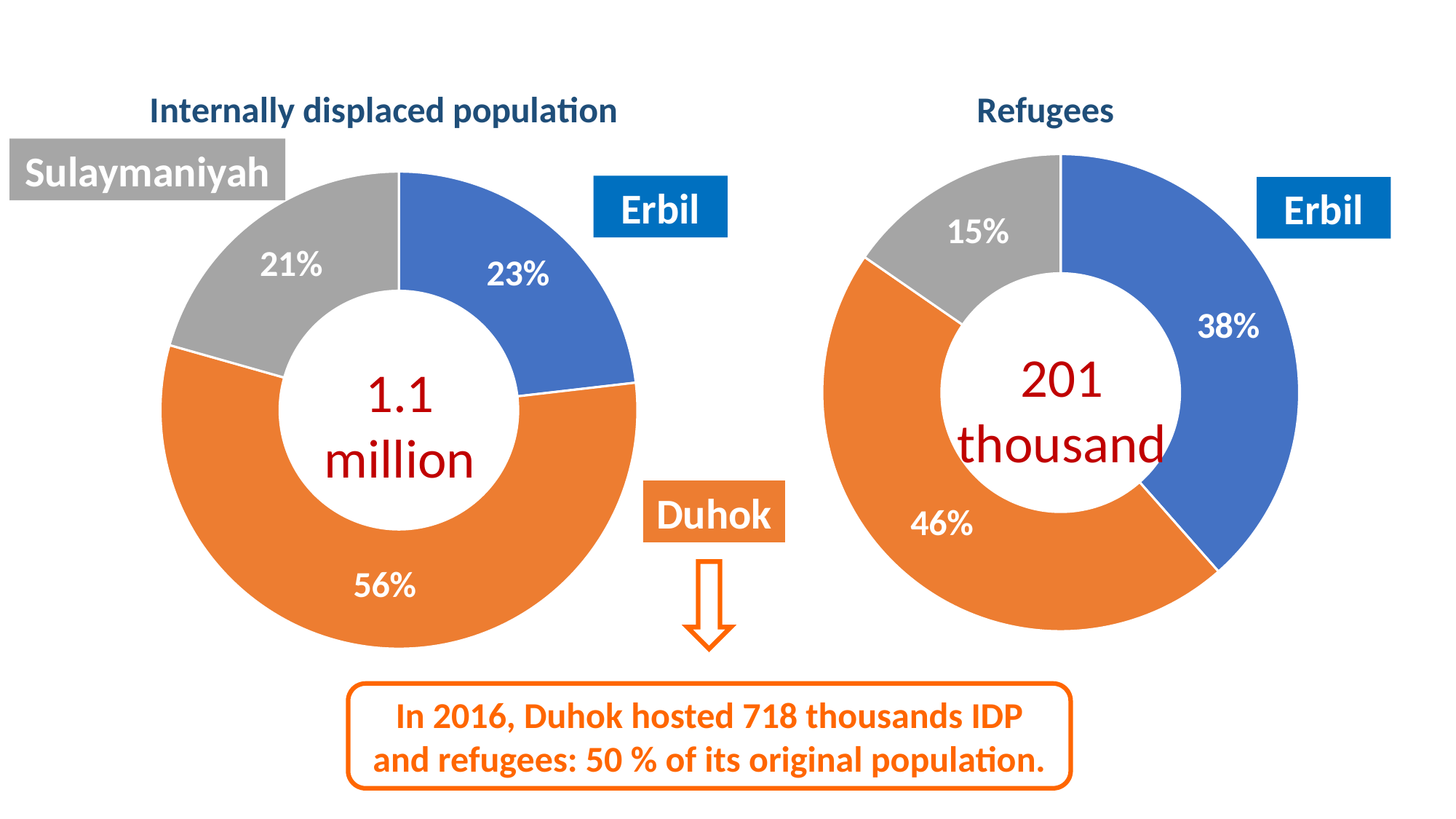
How many slices does the Refugees chart have? 3 In the Internally displaced population chart, which region has the largest share? Duhok In the Internally displaced population chart, what share is shown for Sulaymaniyah? 21% In the Internally displaced population chart, what share is shown for Duhok? 56% In the Internally displaced population chart, which region has the smallest share? Sulaymaniyah What total is printed in the centre of the Refugees chart? 201 thousand What kind of chart is used for the Internally displaced population? Donut (pie) chart In the Internally displaced population chart, what is the difference in percentage points between Duhok and Erbil? 33 In the Refugees chart, what is the difference in percentage points between the largest slice and Erbil? 8 In the Refugees chart, what share is shown for Erbil? 38% In the Refugees chart, what percentage is shown on the largest slice? 46% In the Internally displaced population chart, what share is shown for Erbil? 23%